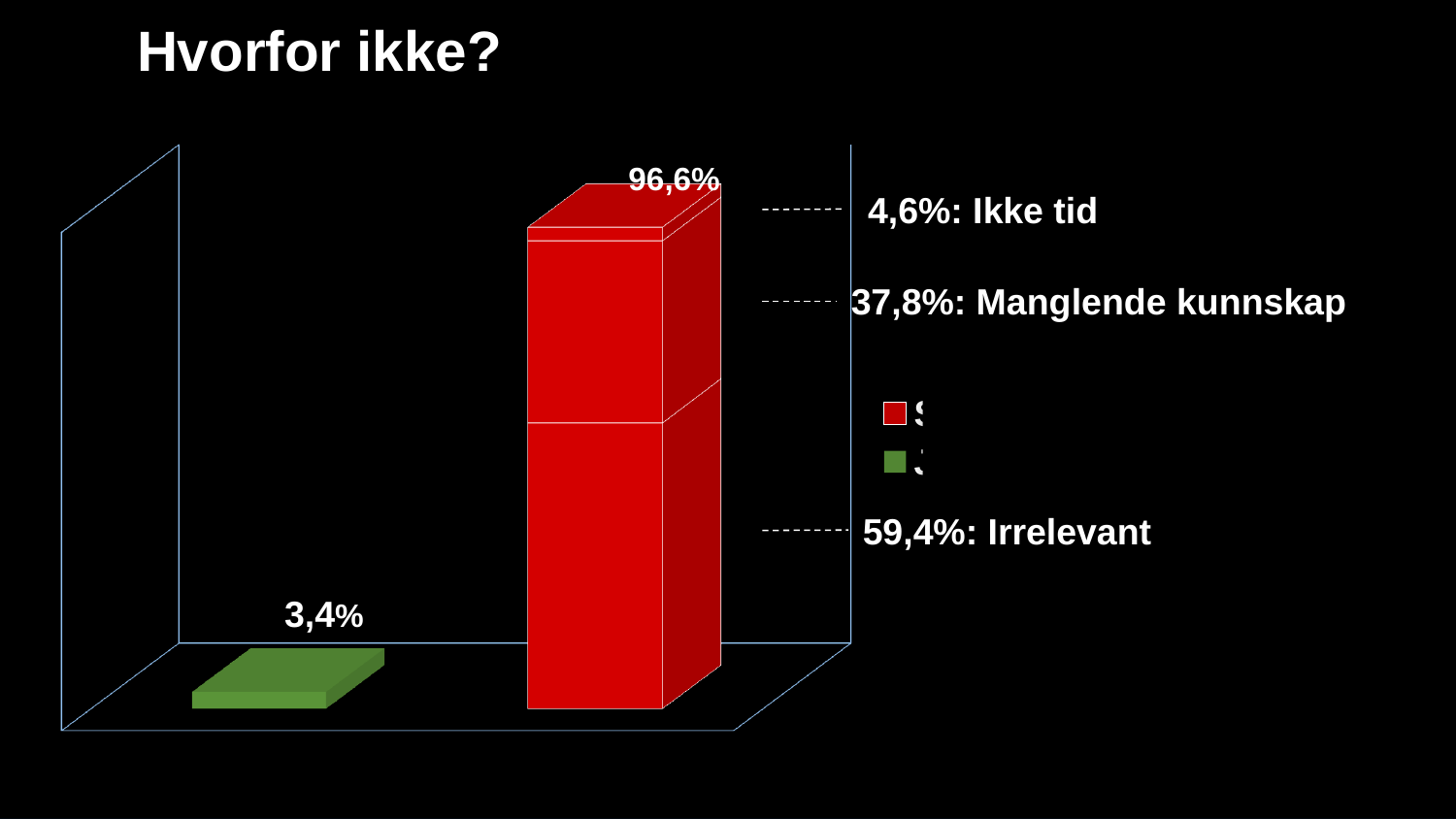
What kind of chart is shown on the slide? bar chart What value is printed on the green bar? 3,4% What percentage is given for 'Ikke tid' in the annotations next to the red bar? 4,6% How many entries does the legend list? 2 What percentage is given for 'Irrelevant'? 59,4% Of the three reasons annotated next to the red bar (Ikke tid, Manglende kunnskap, Irrelevant), which has the highest percentage? Irrelevant What value is printed on the red bar? 96,6% What is the difference between the red bar's value (96,6%) and the green bar's value (3,4%)? 93,2% Which bar is taller, the red bar or the green bar? the red bar What is the title of the slide? Hvorfor ikke? What percentage is given for 'Manglende kunnskap'? 37,8% How many bars are plotted in the chart? 2